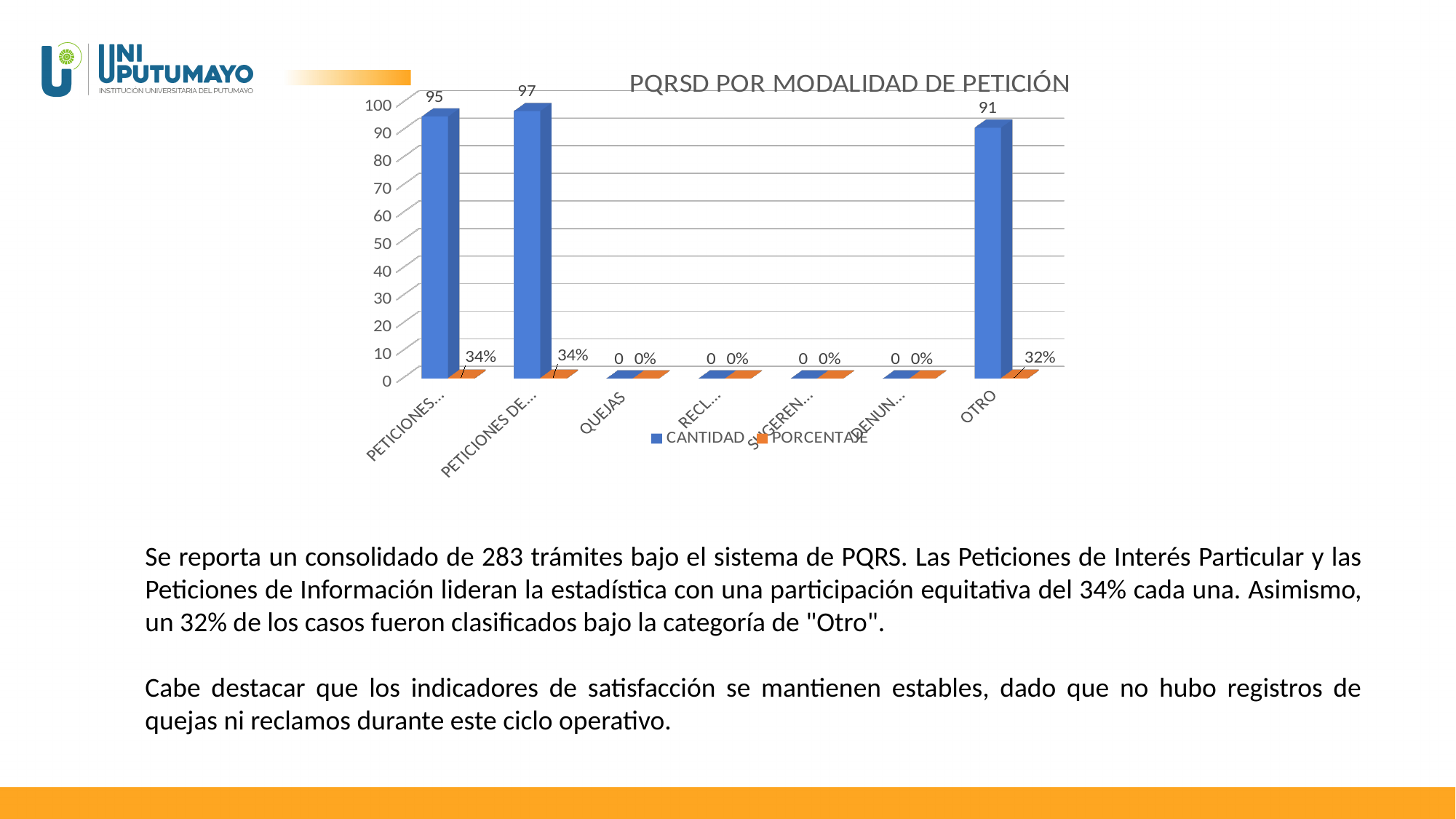
What is the CANTIDAD value for OTRO? 91 Which has a larger CANTIDAD value, OTRO or QUEJAS? OTRO How many categories have a CANTIDAD value of 0? 4 What is the PORCENTAJE value for OTRO? 32% Is the CANTIDAD value for OTRO greater or less than 50? greater What kind of chart is shown on the slide? bar chart What is the title of the chart? PQRSD POR MODALIDAD DE PETICIÓN What is the CANTIDAD value for QUEJAS? 0 How many series does the legend of the chart list? 2 How many categories are shown on the x axis of the chart? 7 What is the highest CANTIDAD value shown in the chart? 97 What is the difference between the highest CANTIDAD value (97) and the CANTIDAD value for OTRO? 6